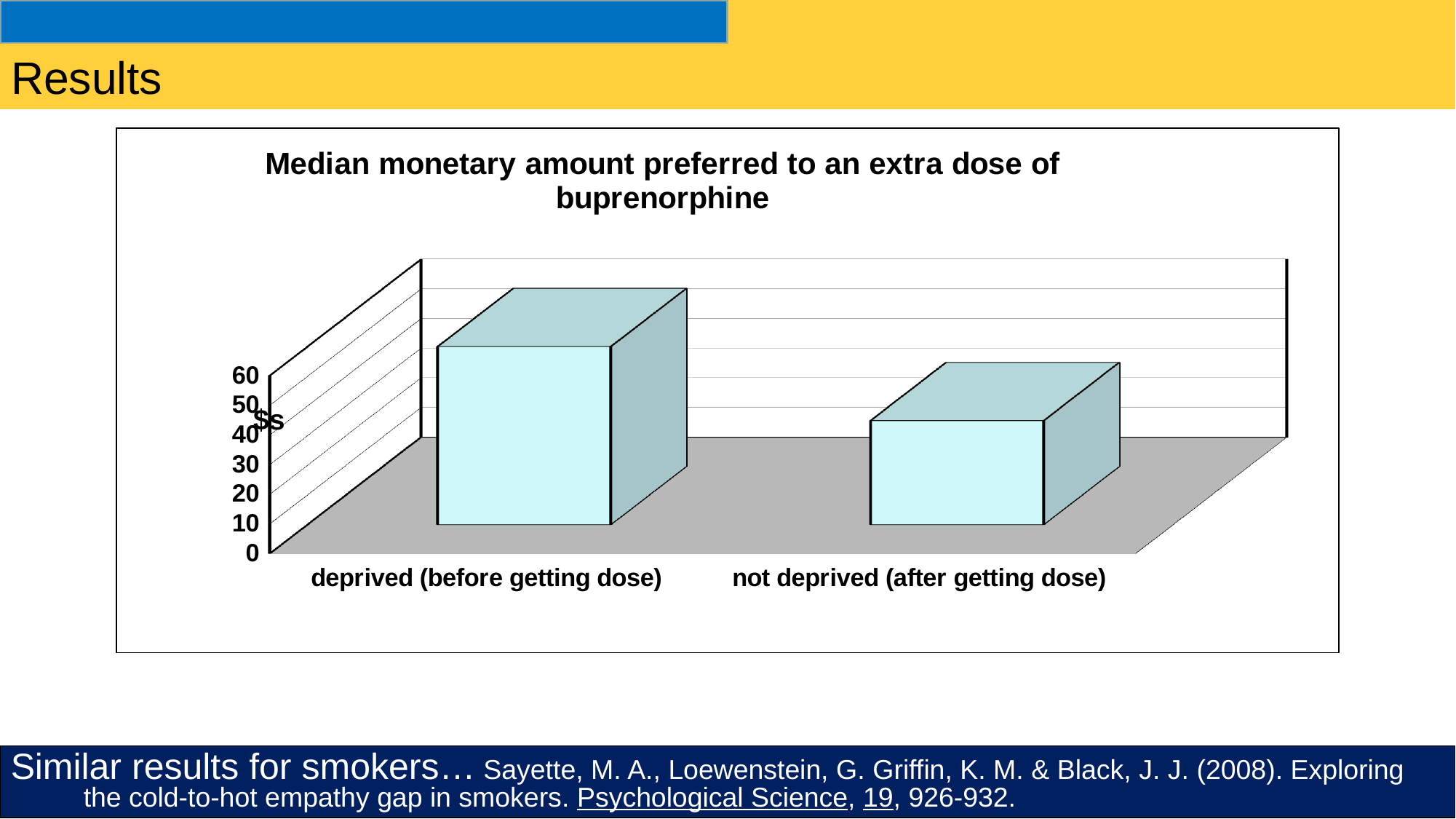
Is the value for not deprived (after getting dose) greater or less than 20? greater What kind of chart is shown on the slide? bar chart Is the value for deprived (before getting dose) greater or less than 40? greater What is the highest tick value shown on the vertical axis? 60 How many categories are shown on the x axis of the chart? 2 Which is larger: the value for deprived (before getting dose) or for not deprived (after getting dose)? deprived (before getting dose) Which category has the highest median monetary amount? deprived (before getting dose) What is the label on the vertical axis of the chart? $s What is the title of the chart? Median monetary amount preferred to an extra dose of buprenorphine Which category has the lowest median monetary amount? not deprived (after getting dose) Do the values rise or fall from the deprived category to the not deprived category? fall Is the value for not deprived (after getting dose) greater or less than 50? less